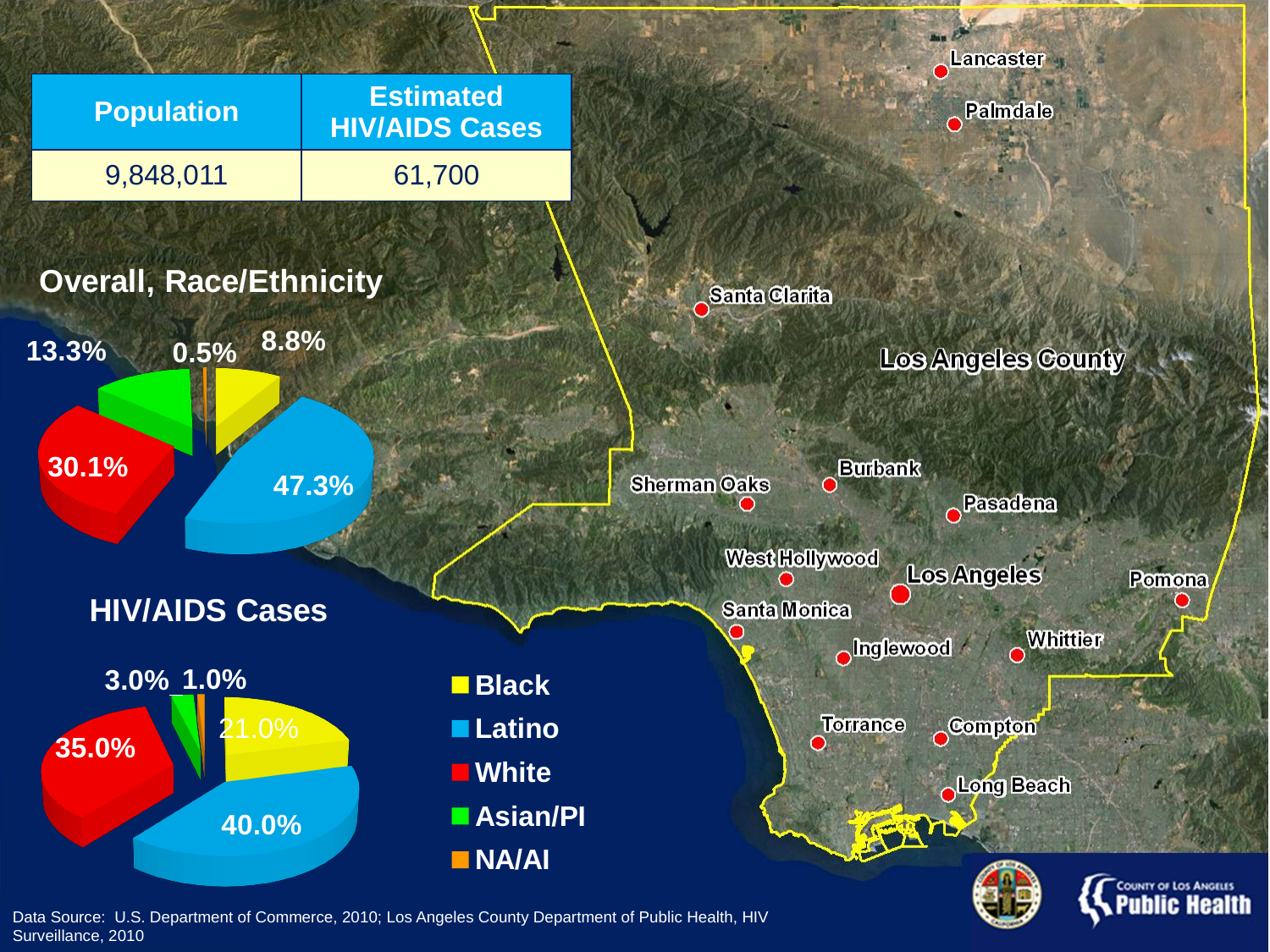
In the 'HIV/AIDS Cases' pie chart, what is the difference between the Latino and White shares? 5.0% In the 'Overall, Race/Ethnicity' pie chart, which is larger, the Asian/PI share or the Black share? Asian/PI What type of chart is the 'HIV/AIDS Cases' chart? Pie chart In the 'Overall, Race/Ethnicity' pie chart, what share is White? 30.1% In the 'Overall, Race/Ethnicity' pie chart, which group has the largest share? Latino In the 'HIV/AIDS Cases' pie chart, what share is Latino? 40.0% In the 'Overall, Race/Ethnicity' pie chart, what share is Asian/PI? 13.3% Which colour represents White in the pie charts' legend? Red In the 'Overall, Race/Ethnicity' pie chart, what share is Latino? 47.3% In the 'HIV/AIDS Cases' pie chart, which group has the smallest share? NA/AI How many groups does the legend list for the pie charts? 5 In the 'HIV/AIDS Cases' pie chart, what share is Black? 21.0%